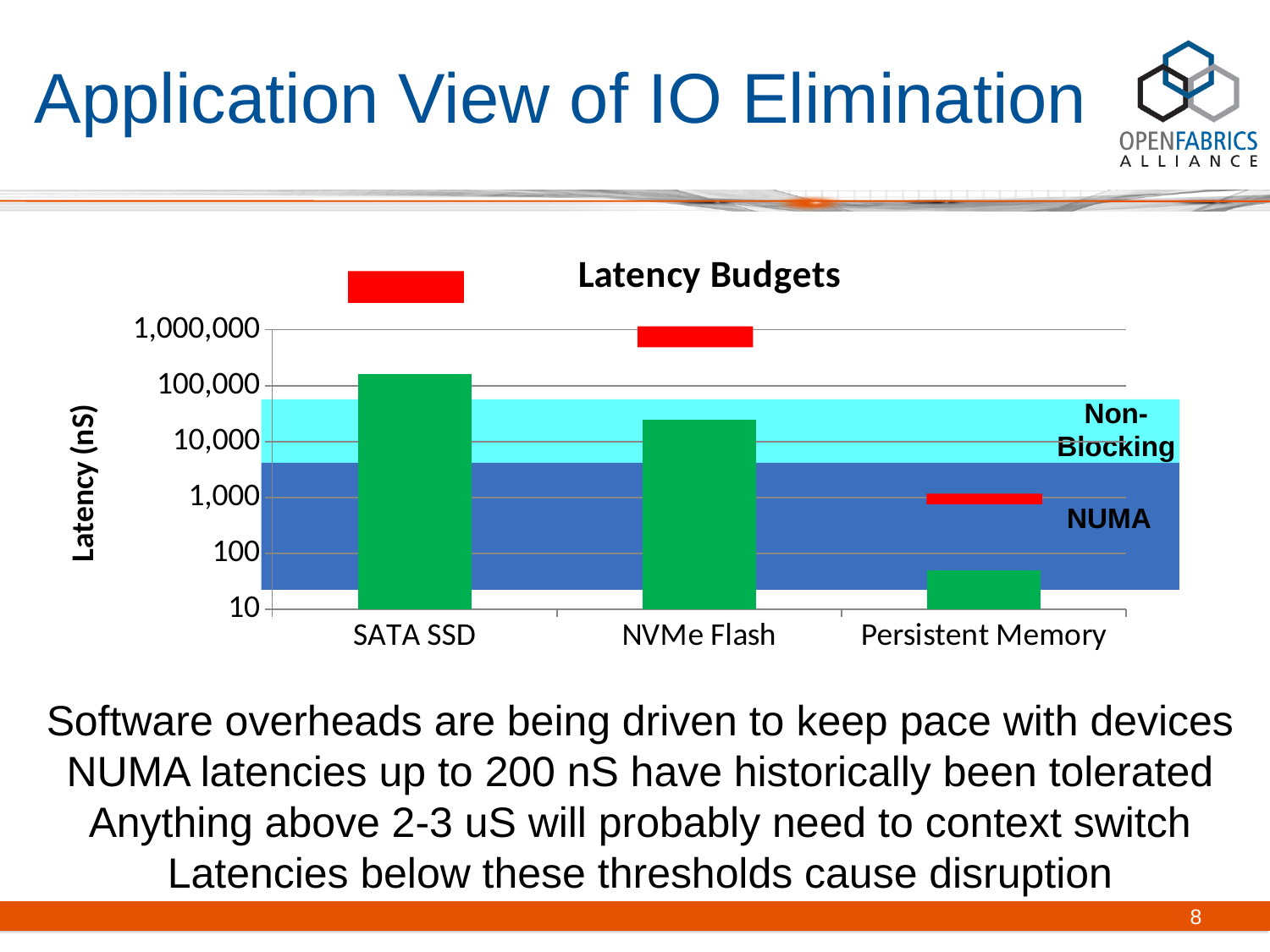
Is the value for NVMe Flash greater or less than 100,000? less Which category has the highest latency in the chart? SATA SSD Which has the larger latency, NVMe Flash or Persistent Memory? NVMe Flash What kind of chart is shown on the slide? bar chart Do the bar values rise or fall from left to right across the x axis? fall Is the value for SATA SSD greater or less than 100,000? greater What is the title of the chart? Latency Budgets Is the value for NVMe Flash greater or less than 10,000? greater What is the label on the y axis of the chart? Latency (nS) Which category has the lowest latency in the chart? Persistent Memory How many categories are shown on the x axis of the chart? 3